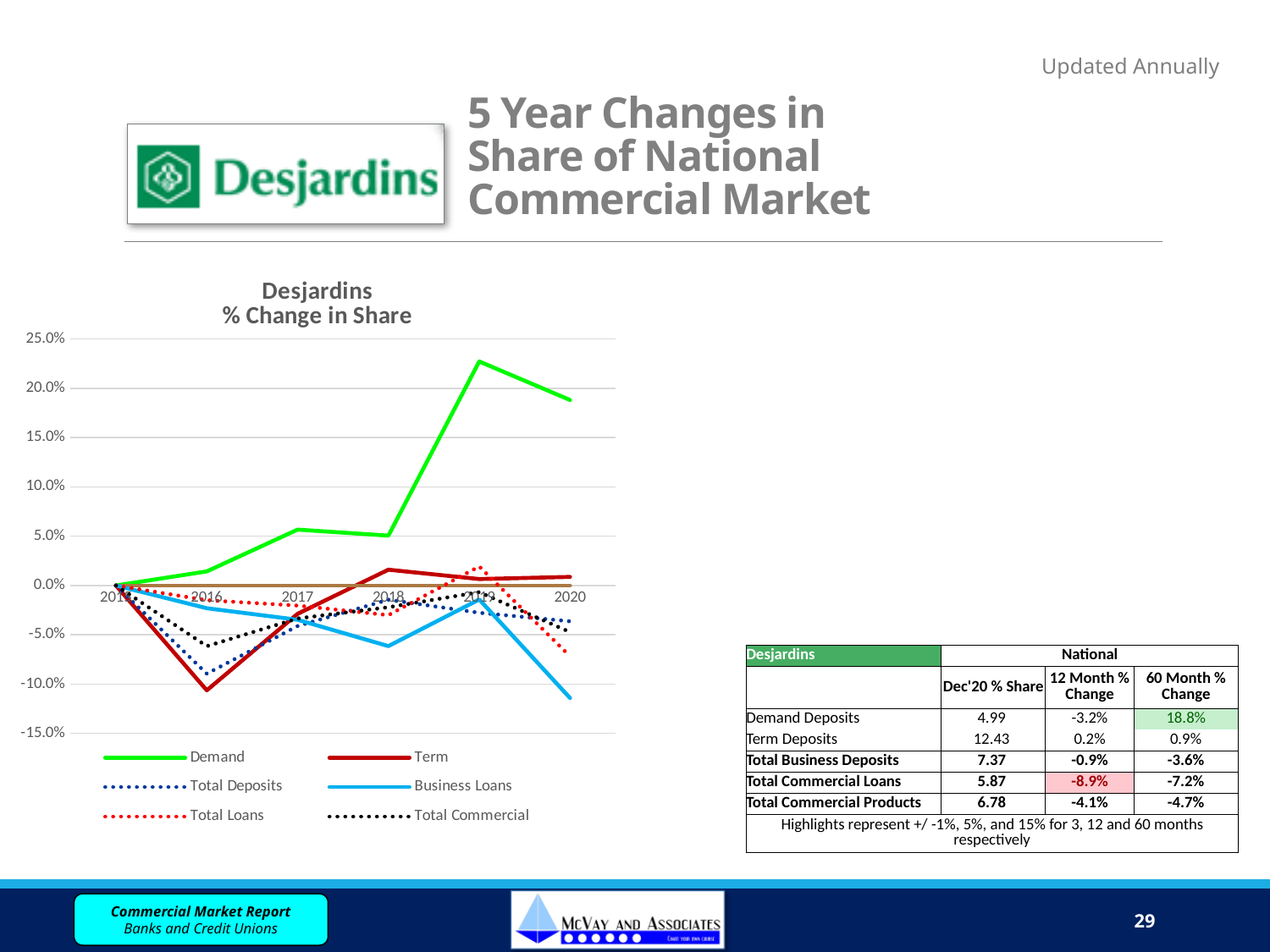
Which is larger in 2019, the value for Demand or the value for Term? Demand How many series does the chart legend list? 6 Is the value for Business Loans in 2020 greater or less than -5.0%? less What kind of chart is shown on the slide? line chart What is the title of the chart? Desjardins % Change in Share In which year does the Term series reach its lowest point? 2016 Does the Demand series rise or fall from 2019 to 2020? fall In which year does the Demand series reach its highest point? 2019 Which series has the lowest value in 2020? Business Loans Which series has the highest value in 2020? Demand How many years are plotted along the x axis of the chart? 6 Is the value for Demand in 2019 greater or less than 20.0%? greater